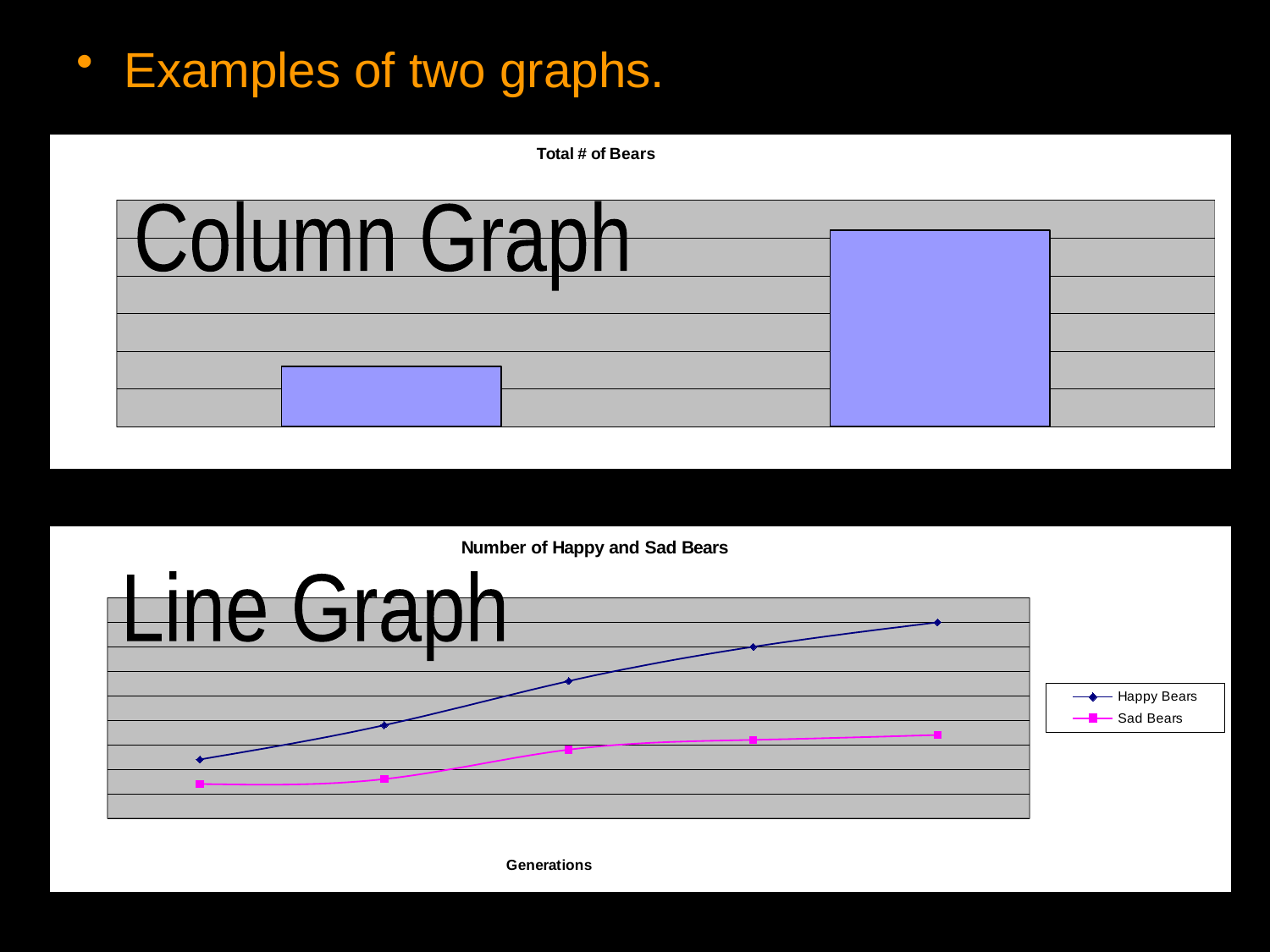
In the 'Number of Happy and Sad Bears' chart, do the Happy Bears values rise or fall across the generations? rise What are the two series named in the legend of the 'Number of Happy and Sad Bears' chart? Happy Bears and Sad Bears In the 'Number of Happy and Sad Bears' chart, how many data points does the Happy Bears line have? 5 What kind of chart is the 'Number of Happy and Sad Bears' chart? line chart In the 'Number of Happy and Sad Bears' chart, do the Sad Bears values rise or fall across the generations? rise In the 'Total # of Bears' chart, which bar is taller, the left bar or the right bar? the right bar In the 'Number of Happy and Sad Bears' chart, which series has the higher values, Happy Bears or Sad Bears? Happy Bears How many series does the legend of the 'Number of Happy and Sad Bears' chart list? 2 What is the x-axis title of the 'Number of Happy and Sad Bears' chart? Generations In the 'Total # of Bears' chart, how many bars are plotted? 2 In the 'Total # of Bears' chart, which bar is the shortest? the left bar What kind of chart is the 'Total # of Bears' chart? bar chart